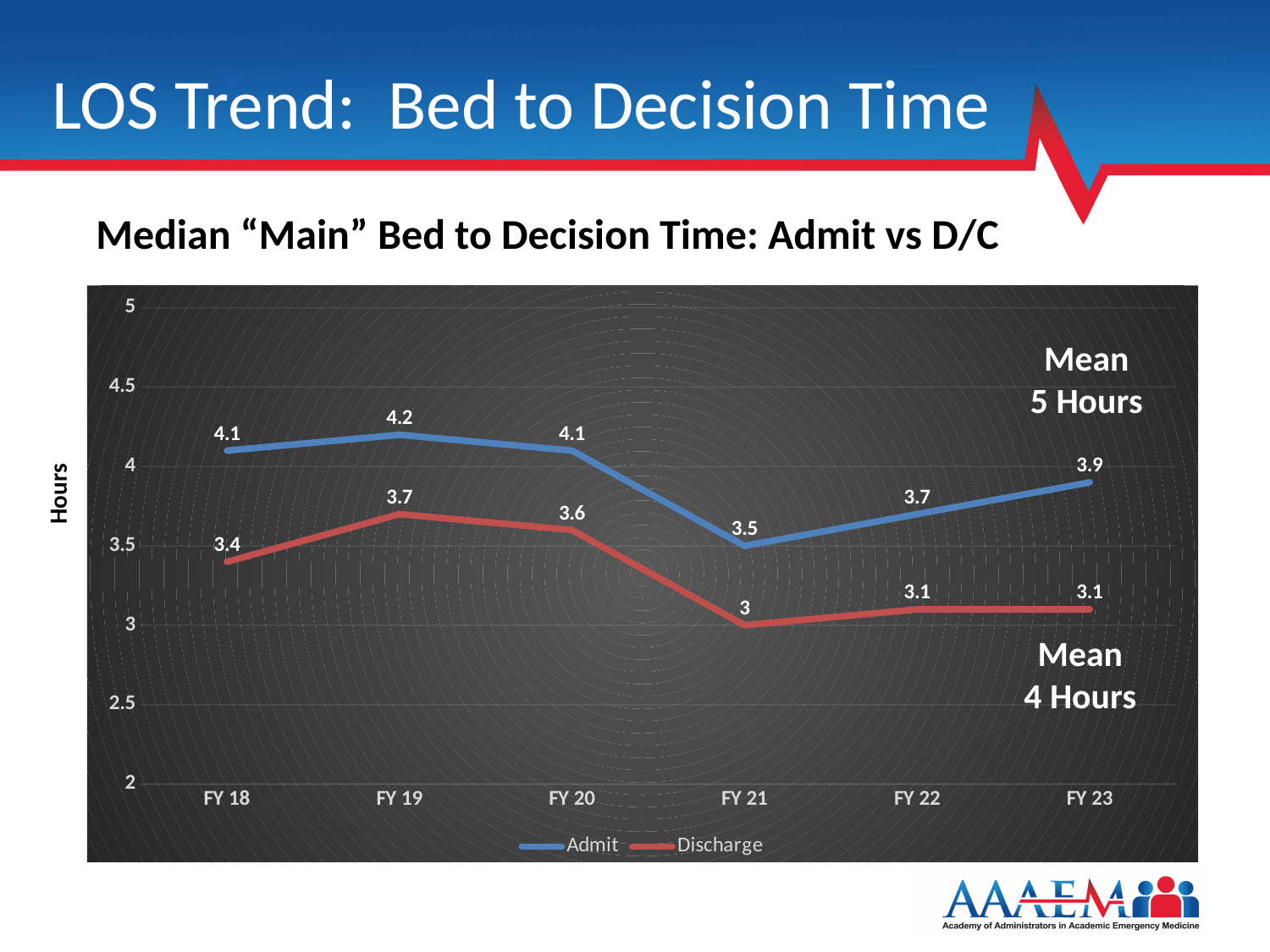
Which is larger in FY 22, the Admit value or the Discharge value? Admit What is the difference between the Admit and Discharge values in FY 18? 0.7 What is the label on the vertical axis? Hours In which fiscal year is the Discharge series lowest? FY 21 In which fiscal year is the Admit series highest? FY 19 How many series does the legend list? 2 What is the Discharge value for FY 21? 3 What is the Admit value for FY 19? 4.2 What is the Admit value for FY 23? 3.9 Does the Discharge series rise or fall from FY 20 to FY 21? Fall What kind of chart is shown on the slide? Line chart How many fiscal years are shown on the x axis? 6